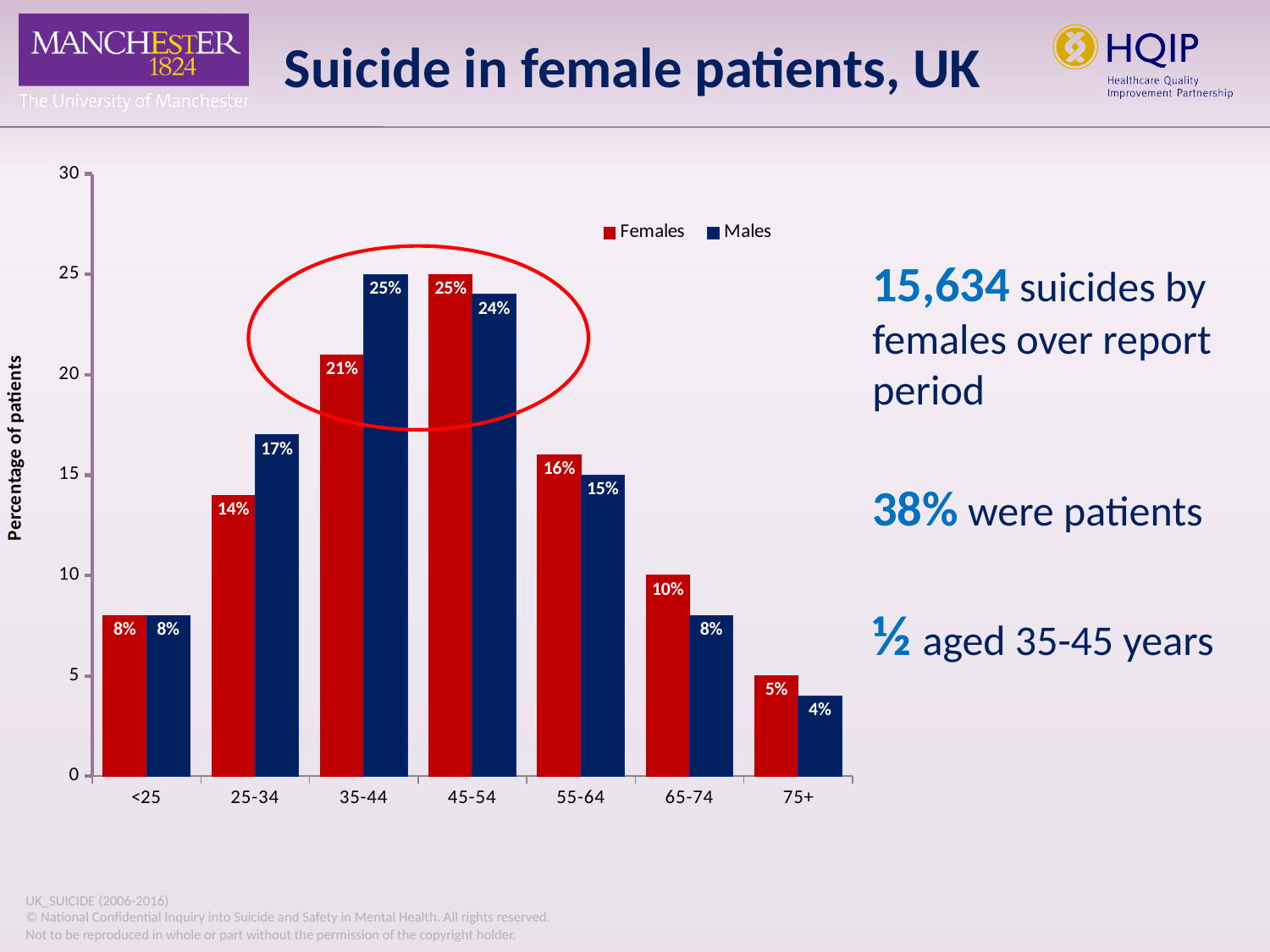
Which age group has the highest value for Females? 45-54 What is the difference between the Females and Males values in the 25-34 age group? 3% Which age group has the lowest value for Males? 75+ What is the value for Males in the 75+ age group? 4% What kind of chart is shown on the slide? Bar chart What percentage of male patients were aged 25-34? 17% How many age groups are shown on the x axis? 7 What percentage of female patients were aged 35-44? 21% What is the label of the y axis? Percentage of patients In the 55-64 age group, which series has the larger value, Females or Males? Females How many series does the legend list? 2 Do the Females values rise or fall from the 45-54 age group to the 75+ age group? Fall